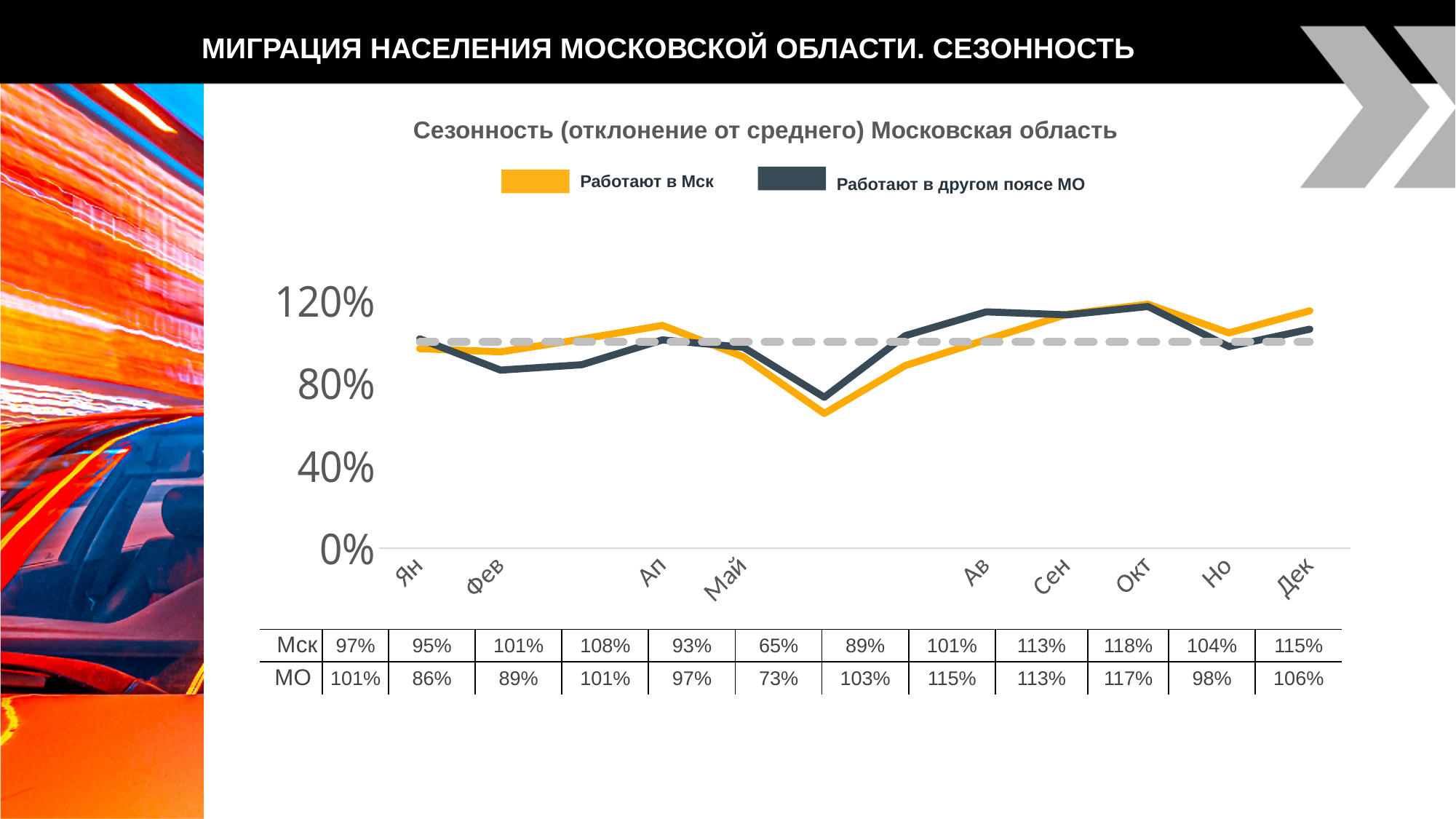
Is the value for МО in Май greater or less than 80%? greater In Ав, which series has the higher value, Мск or МО? МО What is the difference between the Мск and МО values in Фев? 9% In which month does the Мск series reach its highest value? Окт How many series does the legend list? 2 What kind of chart is shown on the slide? line chart What is the value for Мск in Окт? 118% Does the Мск series rise or fall from Ав to Окт? rise What is the value for МО (Работают в другом поясе МО) in Фев? 86% What is the value for Мск (Работают в Мск) in Ян? 97% What is the value for МО in Дек? 106% What is the lowest value shown in the Мск row of the table? 65%